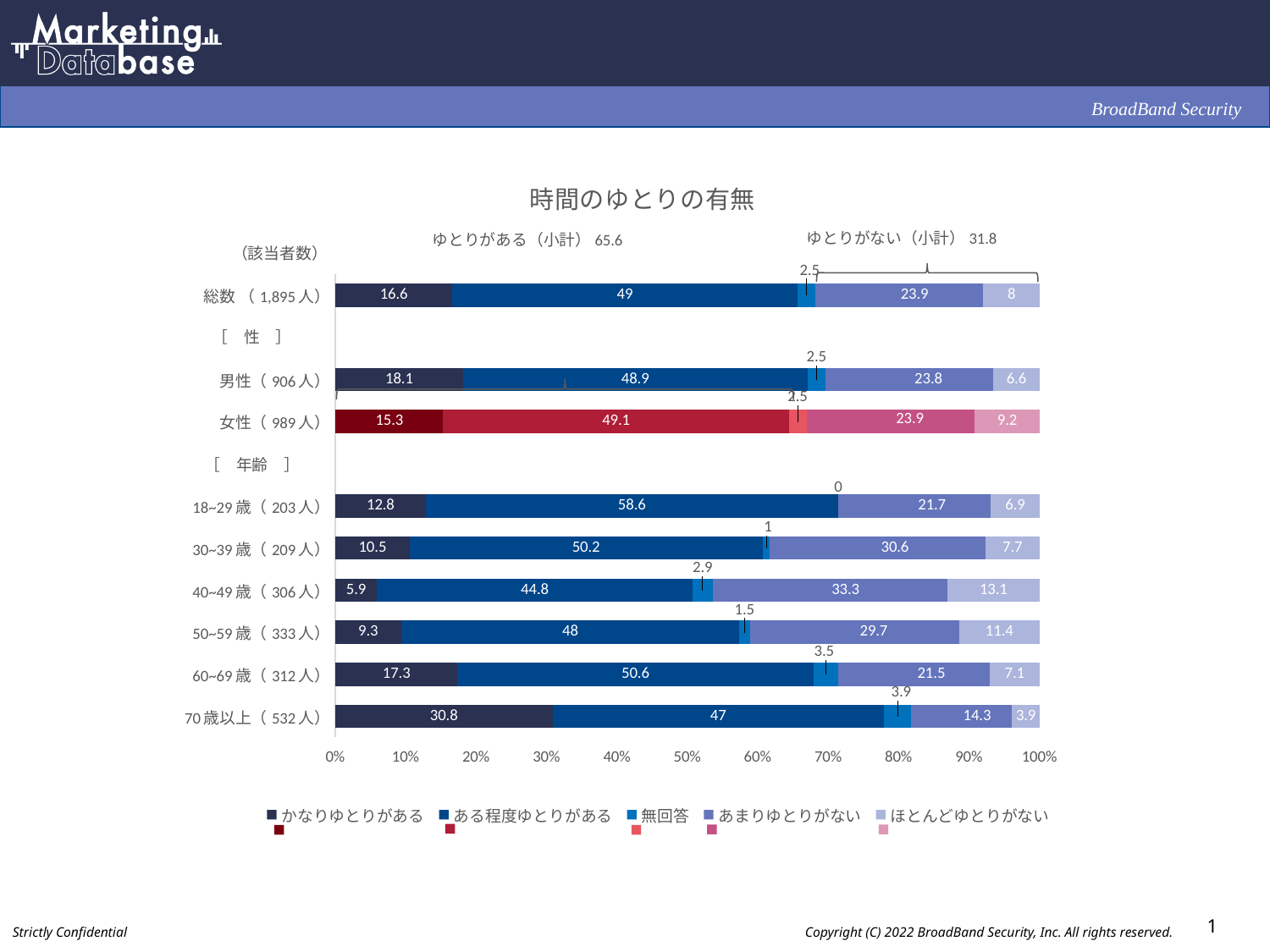
What is the ゆとりがある (小計) value shown above the chart? 65.6 How many series does the legend list? 5 What is the value of かなりゆとりがある for 総数 (1,895人)? 16.6 Which category has the highest value for ある程度ゆとりがある? 18~29歳 (203人) What is the difference between the かなりゆとりがある values for 男性 (906人) and 女性 (989人)? 2.8 Which is larger, the ほとんどゆとりがない value for 40~49歳 (306人) or for 50~59歳 (333人)? 40~49歳 (306人) Which category has the highest value for かなりゆとりがある? 70歳以上 (532人) Which category has the lowest value for かなりゆとりがある? 40~49歳 (306人) What is the value of ほとんどゆとりがない for 女性 (989人)? 9.2 What is the title of the chart? 時間のゆとりの有無 What is the value of あまりゆとりがない for 40~49歳 (306人)? 33.3 What type of chart is shown on the slide? stacked bar chart